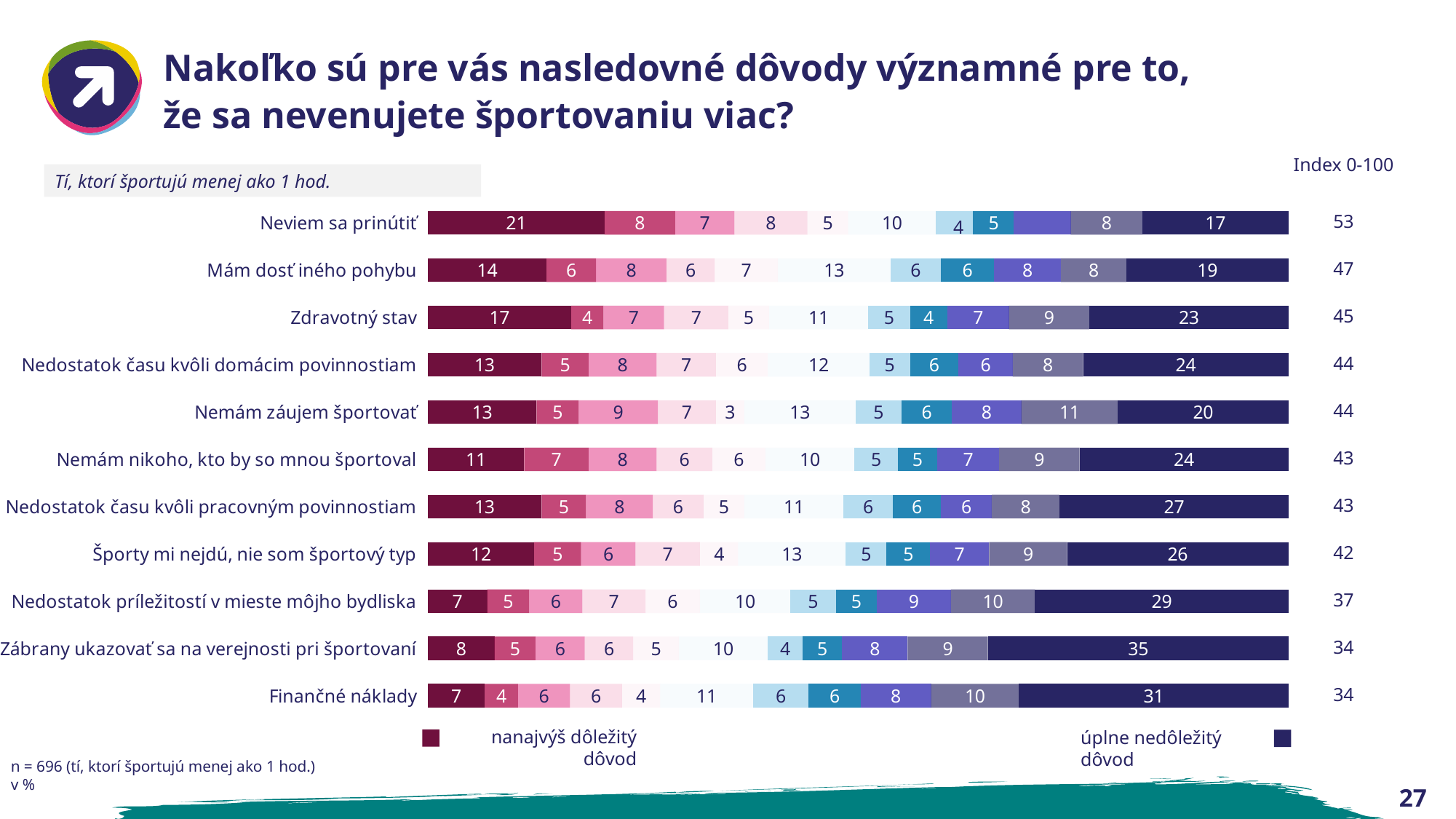
What is the value of the first (dark red) segment for "Zdravotný stav"? 17 What is the sample size (n) stated on the slide? 696 Which reason has the smallest "úplne nedôležitý dôvod" segment? Neviem sa prinútiť Which reason has the largest "nanajvýš dôležitý dôvod" segment (the first, dark red segment)? Neviem sa prinútiť What is the index value (Index 0-100) for "Neviem sa prinútiť"? 53 What percentage of respondents rated "Zábrany ukazovať sa na verejnosti pri športovaní" as "úplne nedôležitý dôvod" (the last, dark navy segment)? 35 What kind of chart is shown on the slide? Stacked bar chart Which reason has the highest index value? Neviem sa prinútiť How many reasons (categories) are listed in the chart? 11 Which has a larger "úplne nedôležitý dôvod" segment: "Finančné náklady" or "Nedostatok príležitostí v mieste môjho bydliska"? Finančné náklady What is the difference between the index values of "Neviem sa prinútiť" and "Finančné náklady"? 19 What is the index value for "Športy mi nejdú, nie som športový typ"? 42